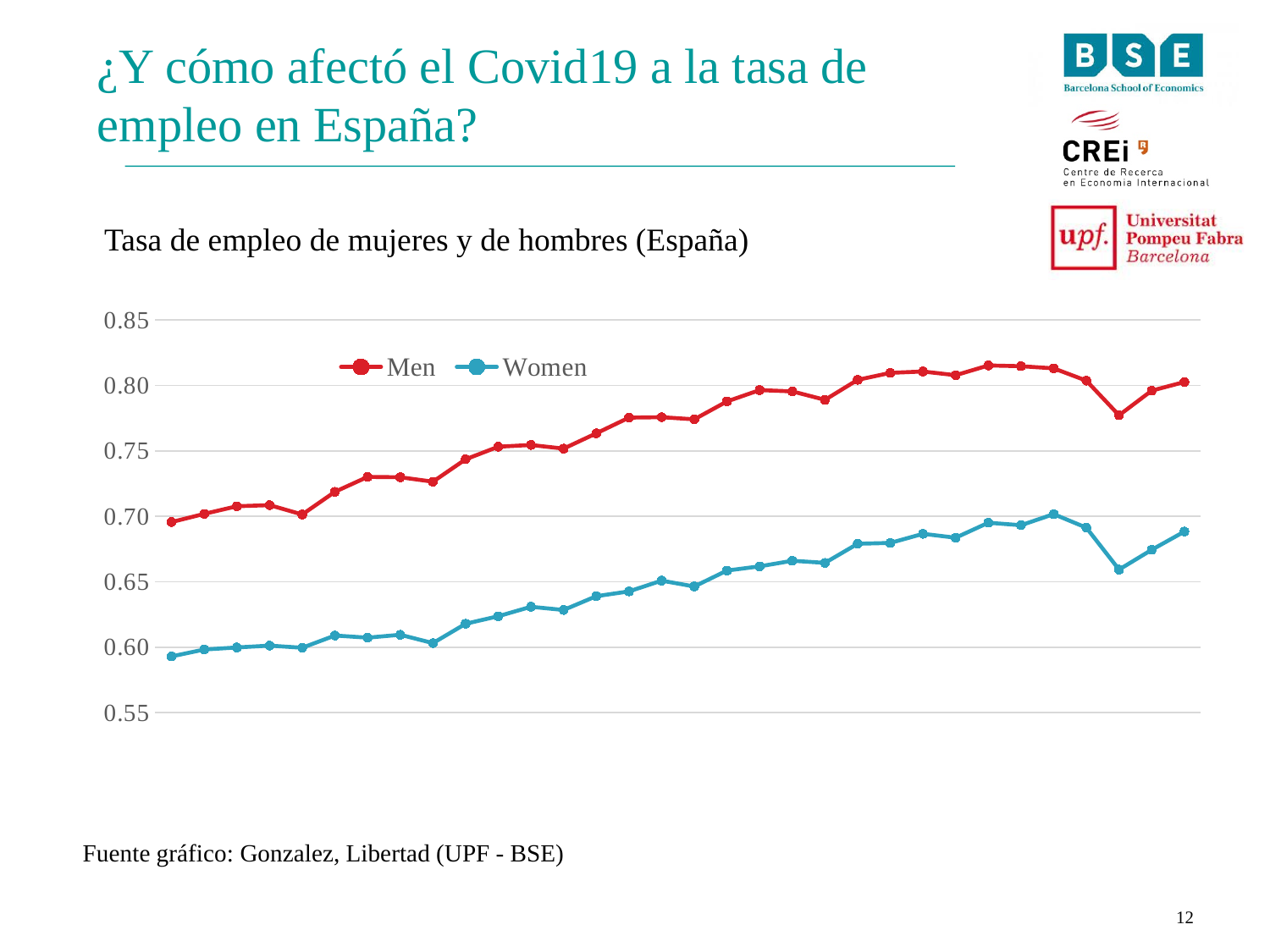
How many series does the legend list? 2 Is the highest value of the Men series greater or less than 0.80? greater Is the value of the Women series at the sharp dip near the right end of the chart greater or less than 0.70? less What colour is the line for the Women series? blue Is the value of the Men series at the sharp dip near the right end of the chart greater or less than 0.80? less What are the two series named in the legend? Men and Women Do the values for the Men series generally rise or fall from left to right across the chart? rise What kind of chart is shown on the slide? line chart Do the values for the Women series generally rise or fall from left to right across the chart? rise Which series has the higher values throughout the chart, Men or Women? Men